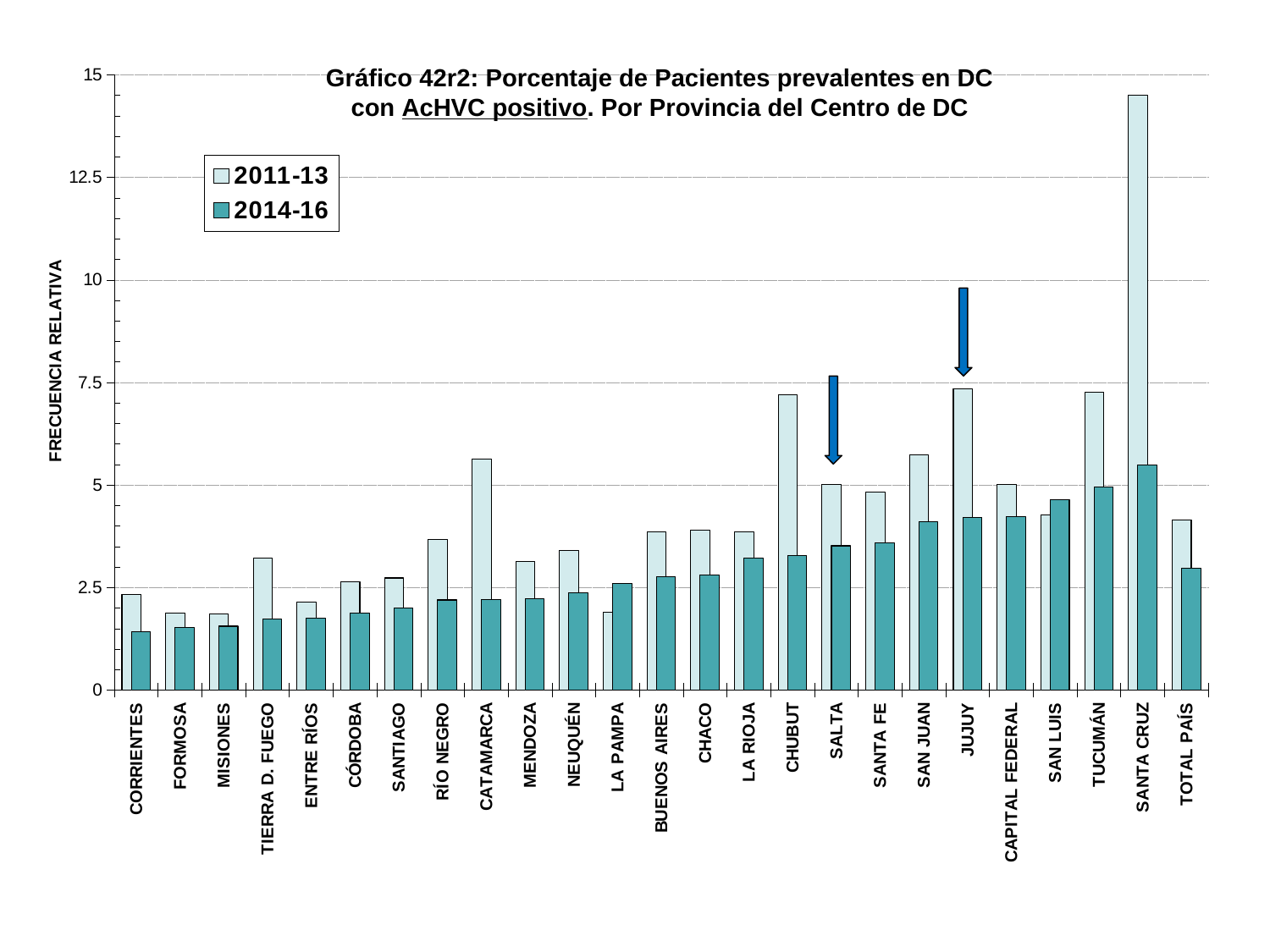
Which category has the highest value for the 2011-13 series? SANTA CRUZ Is the 2011-13 value for SANTA CRUZ greater or less than 12.5? greater How many categories are shown along the x axis? 25 Is the 2014-16 value for SAN LUIS greater or less than 5? less How many series does the legend list? 2 Is the 2014-16 value for CORRIENTES greater or less than 2.5? less Which category has the highest value for the 2014-16 series? SANTA CRUZ For CHUBUT, which series has the larger value, 2011-13 or 2014-16? 2011-13 What is the label of the y axis? FRECUENCIA RELATIVA What kind of chart is shown on the slide? Bar chart For LA PAMPA, which series has the larger value, 2011-13 or 2014-16? 2014-16